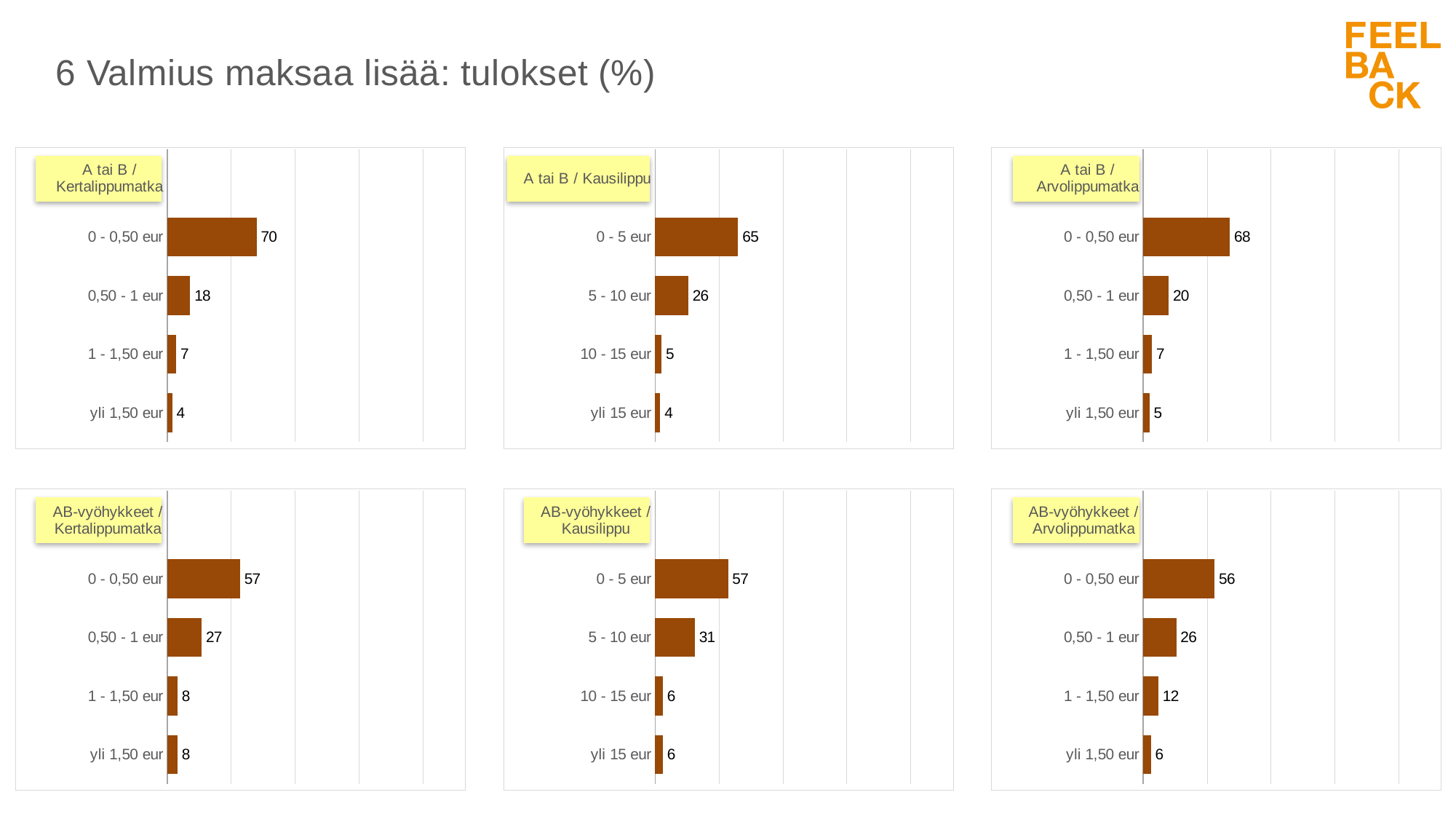
In the 'A tai B / Kausilippu' chart, what is the value for '5 - 10 eur'? 26 In the 'A tai B / Arvolippumatka' chart, which category has the highest value? 0 - 0,50 eur In the 'AB-vyöhykkeet / Kertalippumatka' chart, what is the value for 'yli 1,50 eur'? 8 In the 'A tai B / Arvolippumatka' chart, what is the difference between '0,50 - 1 eur' and 'yli 1,50 eur'? 15 What kind of chart is the 'AB-vyöhykkeet / Arvolippumatka' chart? bar chart In the 'AB-vyöhykkeet / Kertalippumatka' chart, what is the difference between '0 - 0,50 eur' and '0,50 - 1 eur'? 30 How many categories does the 'A tai B / Kertalippumatka' chart show? 4 In the 'AB-vyöhykkeet / Arvolippumatka' chart, what is the value for '1 - 1,50 eur'? 12 How many charts are shown on the slide? 6 In the 'A tai B / Kertalippumatka' chart, what is the value for '0 - 0,50 eur'? 70 In the 'AB-vyöhykkeet / Kausilippu' chart, which is larger: '0 - 5 eur' or '5 - 10 eur'? 0 - 5 eur In the 'A tai B / Kausilippu' chart, which category has the lowest value? yli 15 eur